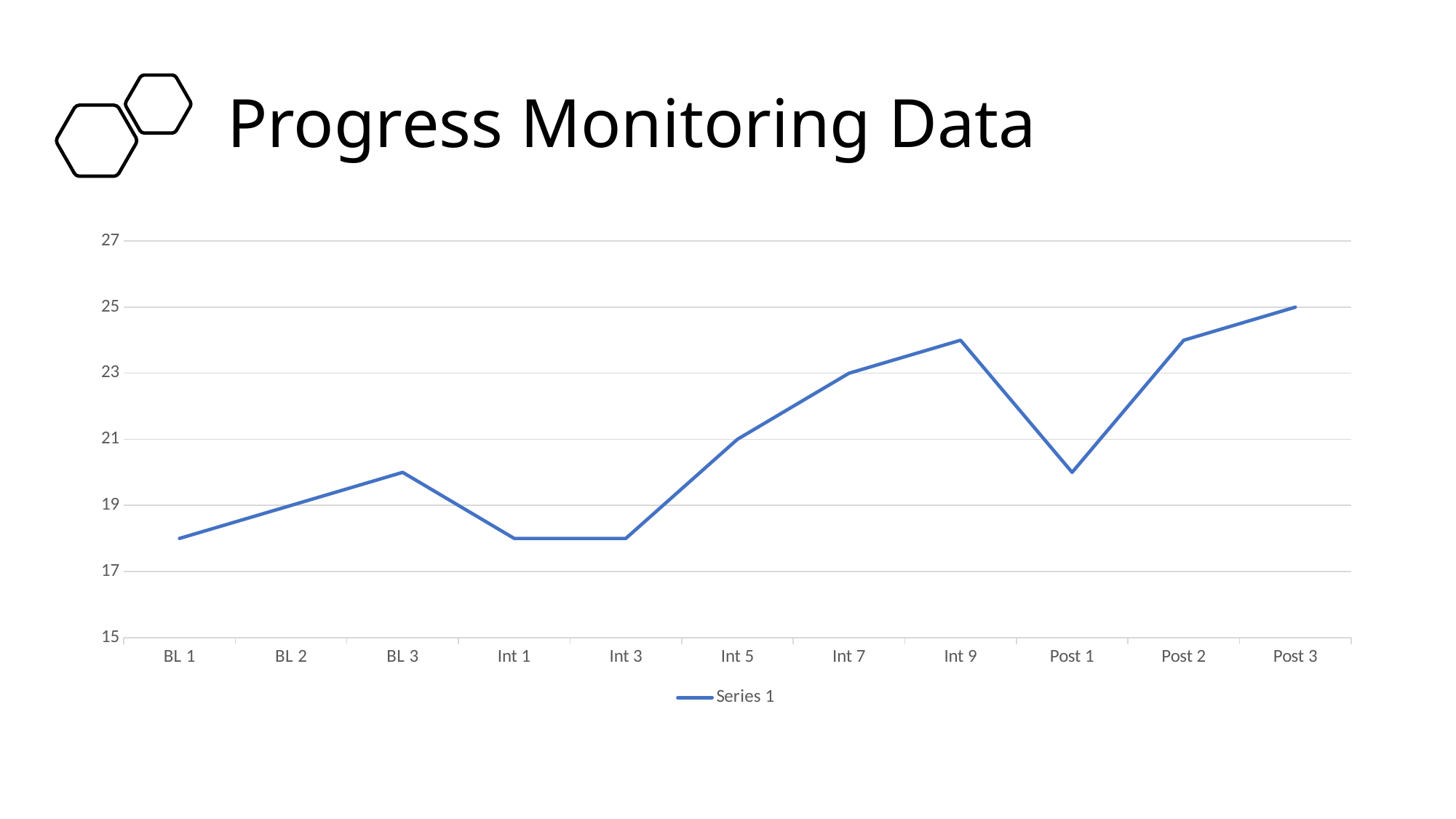
How many series does the legend list? 1 What is the value at Int 5? 21 Is the value for Post 1 greater or less than 21? less What is the value at Int 7? 23 Do the values rise or fall from Int 3 to Int 9? rise What is the difference between the values at Post 3 and Int 5? 4 What is the value at Post 3? 25 Which point has the highest value? Post 3 What is the title of the chart? Progress Monitoring Data How many data points are plotted along the x axis? 11 Which is larger, the value at Int 7 or the value at BL 2? Int 7 What kind of chart is shown on the slide? line chart